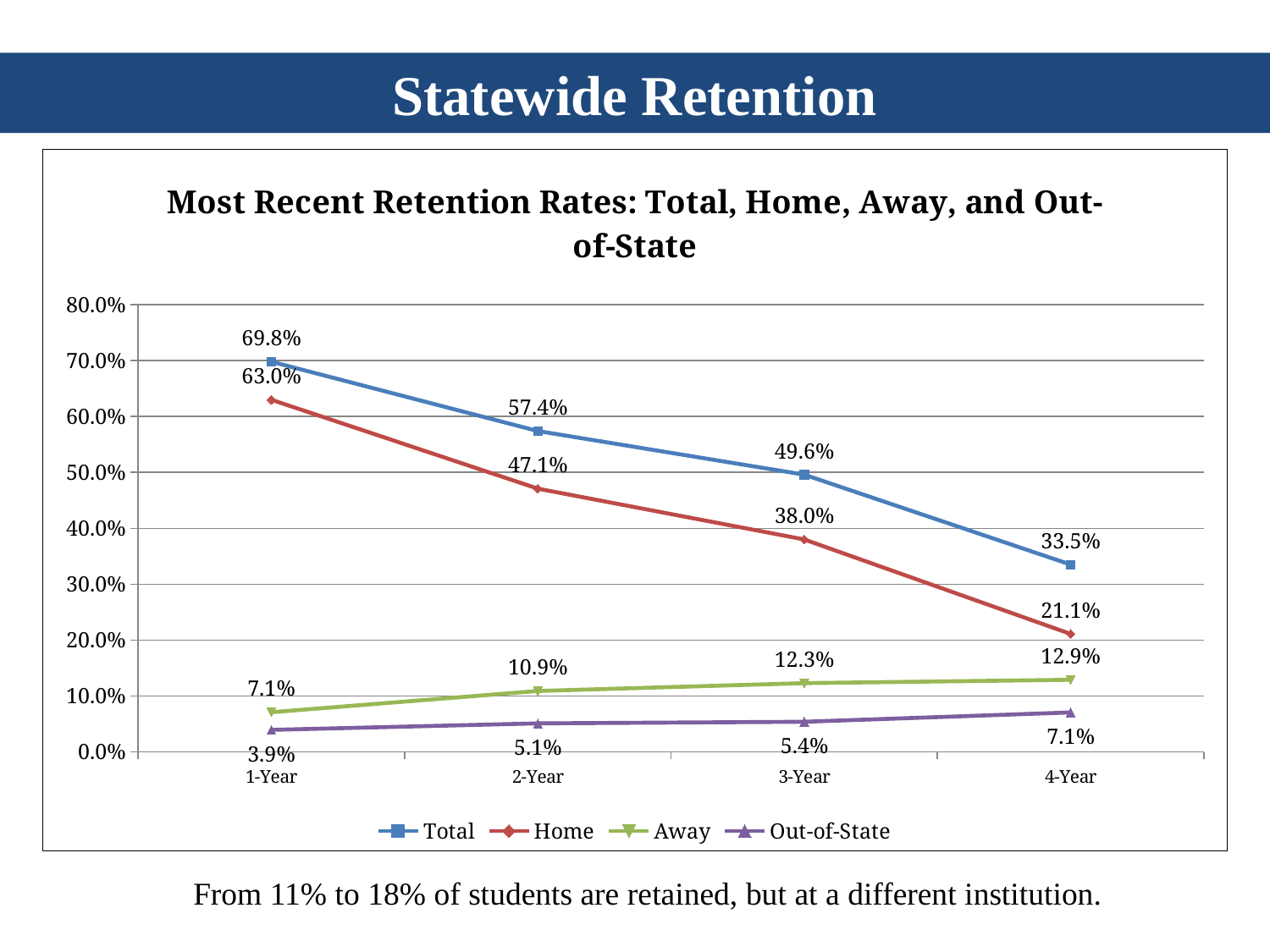
What is the Home retention rate at 4-Year? 21.1% What is the difference between the Total and Home retention rates at 3-Year? 11.6% What is the Away retention rate at 2-Year? 10.9% Which is larger at 2-Year, the Home rate or the Away rate? Home What kind of chart is shown on the slide? Line chart What is the Total retention rate at 1-Year? 69.8% What is the Out-of-State retention rate at 3-Year? 5.4% How many year categories are shown on the x axis? 4 At which year is the Away retention rate highest? 4-Year At which year is the Total retention rate lowest? 4-Year How many series does the legend list? 4 Does the Home retention rate rise or fall from 1-Year to 4-Year? Fall